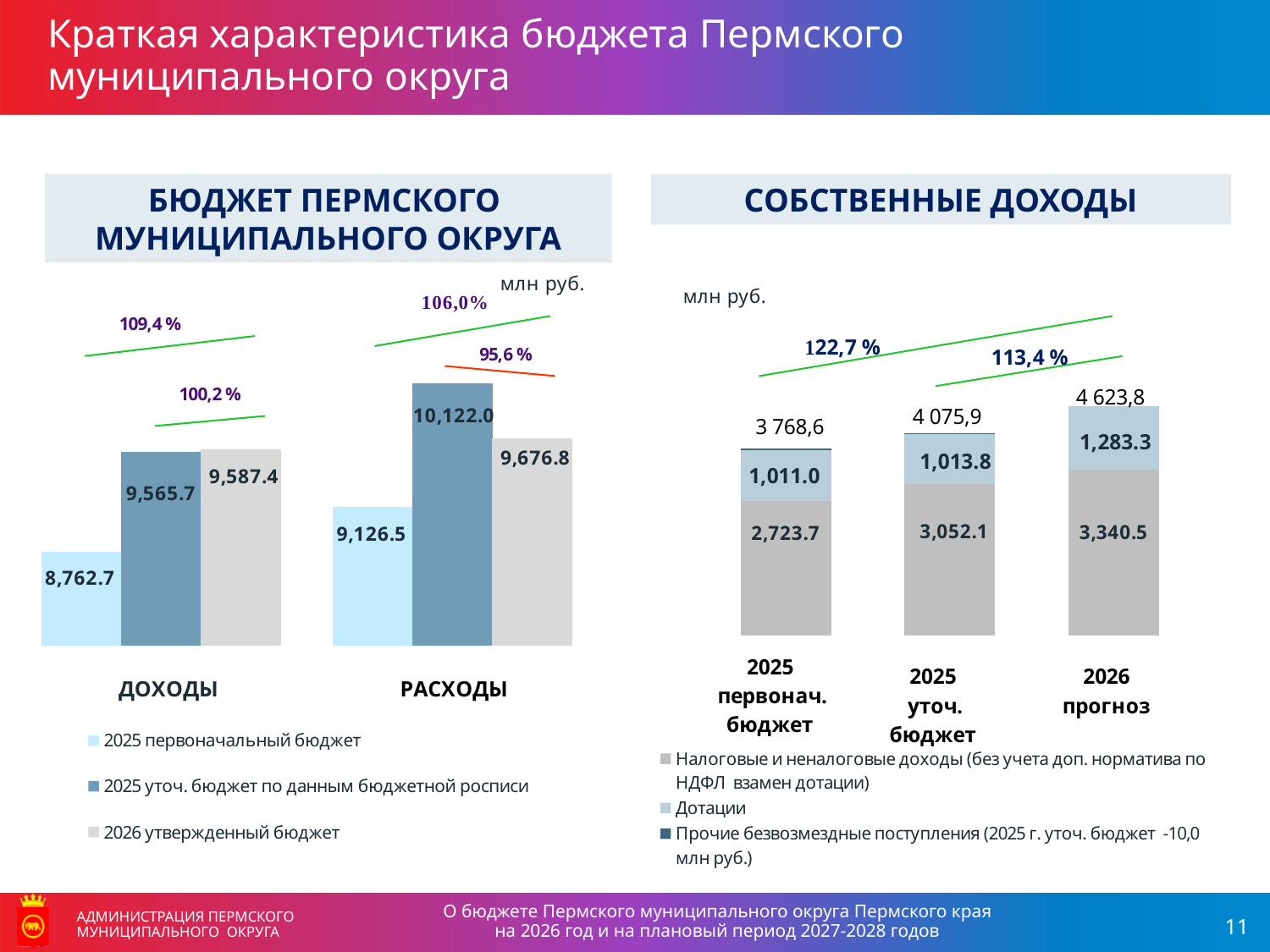
On the chart titled 'БЮДЖЕТ ПЕРМСКОГО МУНИЦИПАЛЬНОГО ОКРУГА', what is the value of РАСХОДЫ for the 2025 уточ. бюджет по данным бюджетной росписи series? 10,122.0 On the chart titled 'СОБСТВЕННЫЕ ДОХОДЫ', do the bar totals rise or fall from 2025 первонач. бюджет to 2026 прогноз? Rise On the chart titled 'СОБСТВЕННЫЕ ДОХОДЫ', what is the value of Налоговые и неналоговые доходы for 2026 прогноз? 3,340.5 On the chart titled 'СОБСТВЕННЫЕ ДОХОДЫ', what is the difference in Дотации between 2026 прогноз and 2025 уточ. бюджет? 269.5 On the chart titled 'СОБСТВЕННЫЕ ДОХОДЫ', what is the total shown above the 2025 уточ. бюджет bar? 4 075,9 On the chart titled 'БЮДЖЕТ ПЕРМСКОГО МУНИЦИПАЛЬНОГО ОКРУГА', what percentage is shown above the ДОХОДЫ group for the change from the 2025 первоначальный бюджет to the 2025 уточ. бюджет? 109,4 % On the chart titled 'СОБСТВЕННЫЕ ДОХОДЫ', what kind of chart is it? Stacked bar chart On the chart titled 'БЮДЖЕТ ПЕРМСКОГО МУНИЦИПАЛЬНОГО ОКРУГА', what is the value of ДОХОДЫ for the 2025 первоначальный бюджет series? 8,762.7 On the chart titled 'БЮДЖЕТ ПЕРМСКОГО МУНИЦИПАЛЬНОГО ОКРУГА', which bar is the lowest? ДОХОДЫ, 2025 первоначальный бюджет (8,762.7) On the chart titled 'БЮДЖЕТ ПЕРМСКОГО МУНИЦИПАЛЬНОГО ОКРУГА', which bar is the highest? РАСХОДЫ, 2025 уточ. бюджет по данным бюджетной росписи (10,122.0) On the chart titled 'БЮДЖЕТ ПЕРМСКОГО МУНИЦИПАЛЬНОГО ОКРУГА', what is the difference between РАСХОДЫ in the 2025 уточ. бюджет series and in the 2026 утвержденный бюджет series? 445.2 On the chart titled 'БЮДЖЕТ ПЕРМСКОГО МУНИЦИПАЛЬНОГО ОКРУГА', how many series does the legend list? 3